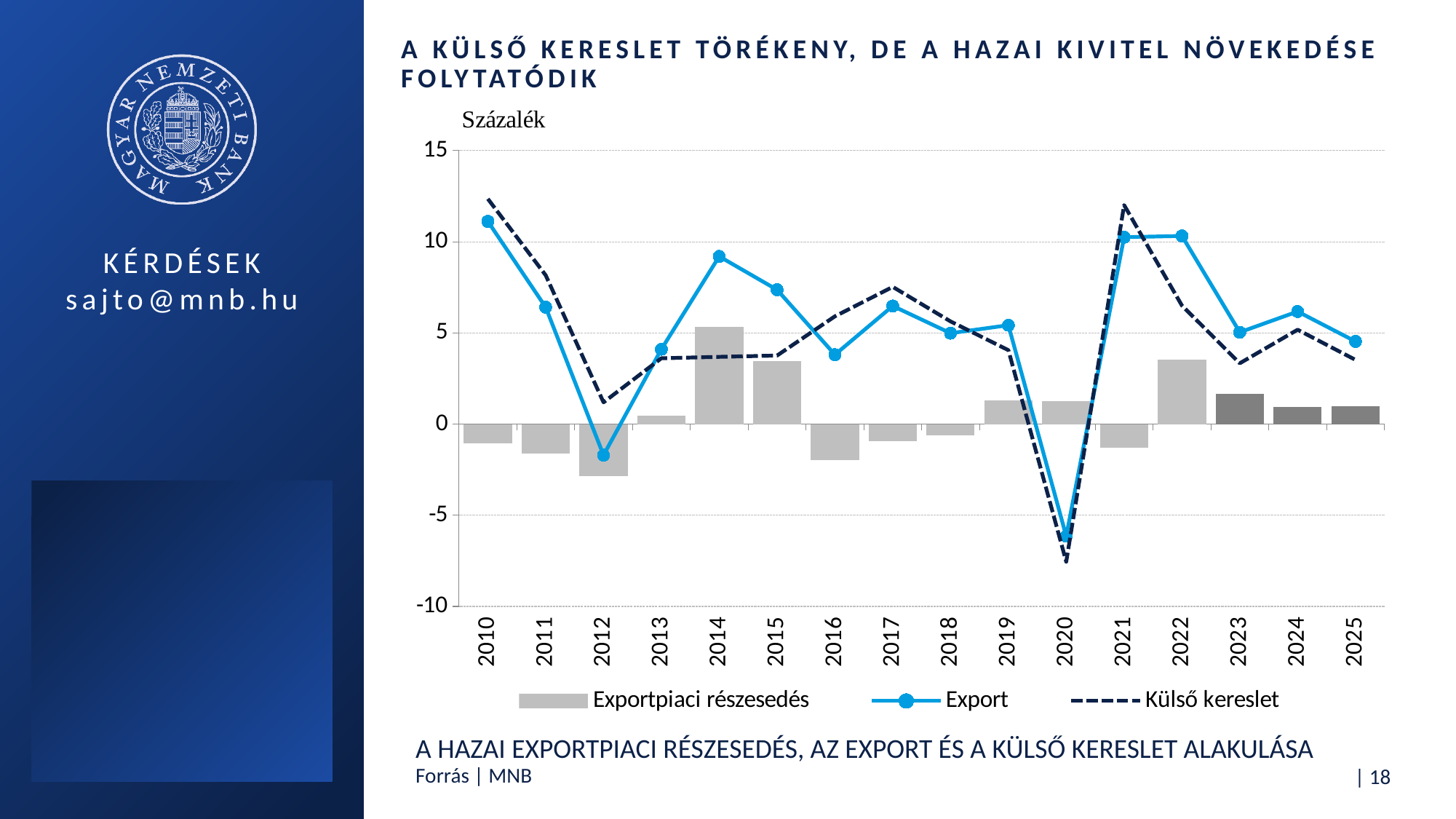
What unit label is shown above the y axis? Százalék In which year is the Exportpiaci részesedés bar the tallest? 2014 In which year is the Külső kereslet series at its lowest? 2020 How many years are shown on the x axis? 16 How many series does the legend list? 3 What kind of chart is shown on the slide? A combined bar and line chart In 2014, which is larger: Export or Külső kereslet? Export In which year is the Exportpiaci részesedés bar the lowest (most negative)? 2012 Is the Külső kereslet value for 2020 greater or less than -5? less Is the Export value for 2010 greater or less than 10? greater In which year is the Export series at its lowest? 2020 In which year is the Export series at its highest? 2010